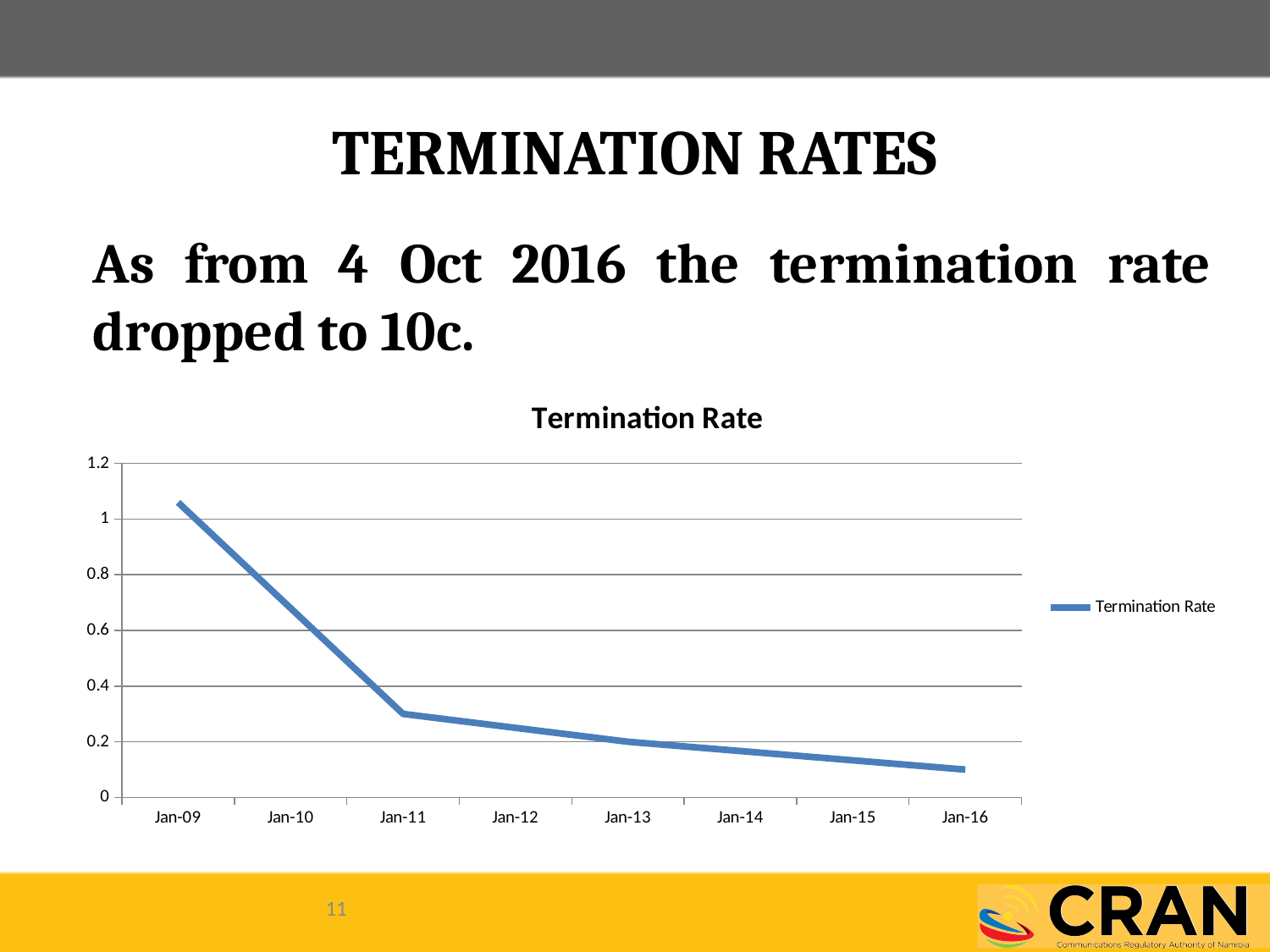
Which date has the highest termination rate? Jan-09 What is the name of the series shown in the legend? Termination Rate Is the value for Jan-11 greater or less than 0.4? less What is the title of the chart? Termination Rate How many series does the legend list? 1 Do the values rise or fall from Jan-09 to Jan-16? fall Is the value for Jan-16 greater or less than 0.2? less Which date has the lowest termination rate? Jan-16 Which is larger, the value for Jan-10 or the value for Jan-13? Jan-10 Is the value for Jan-09 greater or less than 1? greater What kind of chart is shown on the slide? line chart